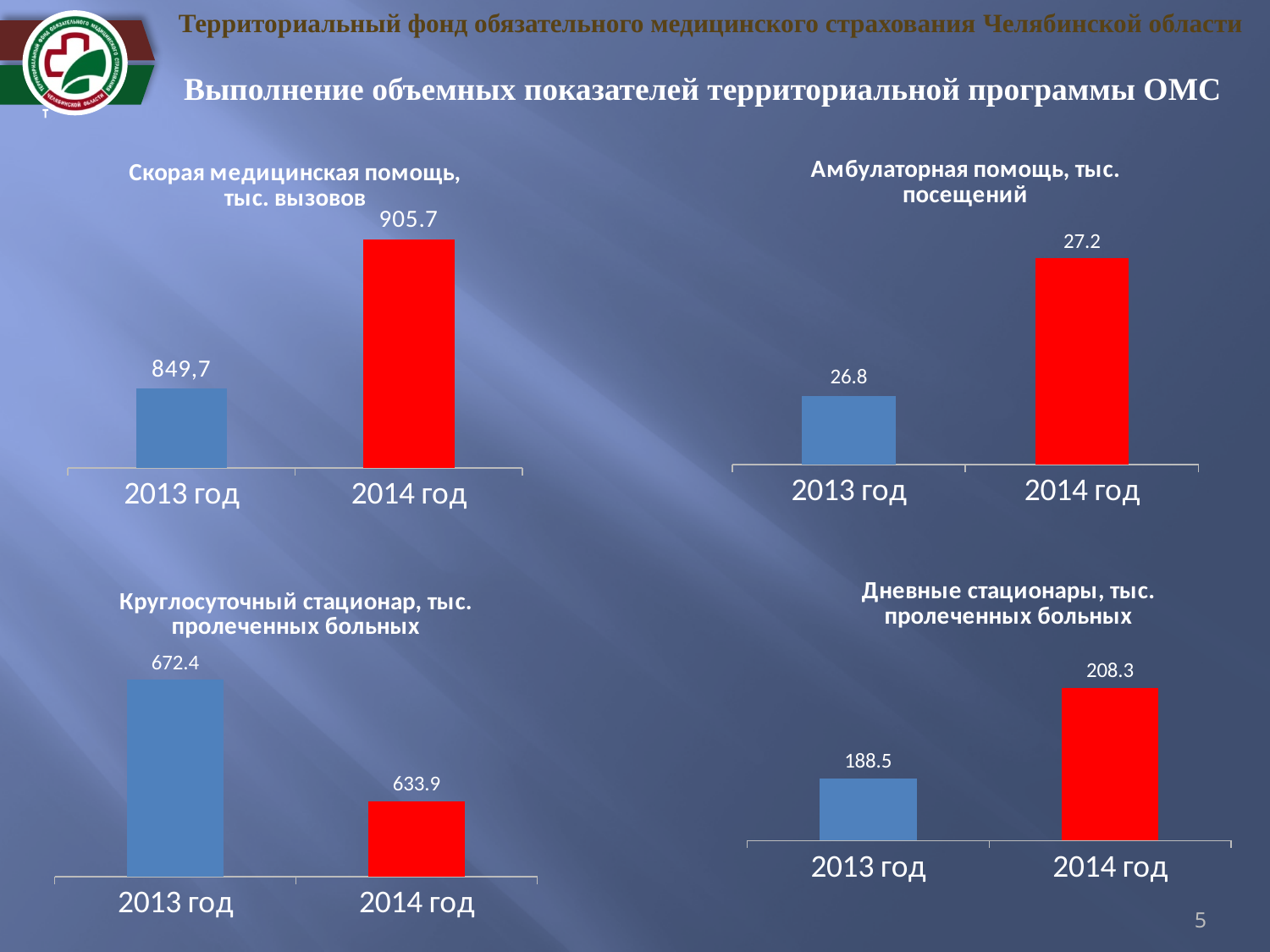
In the chart titled "Дневные стационары, тыс. пролеченных больных", which year has the higher value? 2014 год In the chart titled "Скорая медицинская помощь, тыс. вызовов", what is the value for 2013 год? 849,7 What kind of chart is the one titled "Дневные стационары, тыс. пролеченных больных"? bar chart In the chart titled "Круглосуточный стационар, тыс. пролеченных больных", what is the difference between the 2013 год and 2014 год values? 38.5 In the chart titled "Амбулаторная помощь, тыс. посещений", do the values rise or fall from 2013 год to 2014 год? rise In the chart titled "Круглосуточный стационар, тыс. пролеченных больных", what is the value for 2013 год? 672.4 In the chart titled "Круглосуточный стационар, тыс. пролеченных больных", which year has the lower value? 2014 год How many categories are shown in the chart titled "Скорая медицинская помощь, тыс. вызовов"? 2 In the chart titled "Амбулаторная помощь, тыс. посещений", what is the value for 2014 год? 27.2 In the chart titled "Дневные стационары, тыс. пролеченных больных", what is the difference between the 2014 год and 2013 год values? 19.8 In the chart titled "Дневные стационары, тыс. пролеченных больных", what is the value for 2014 год? 208.3 In the chart titled "Скорая медицинская помощь, тыс. вызовов", what is the value for 2014 год? 905.7